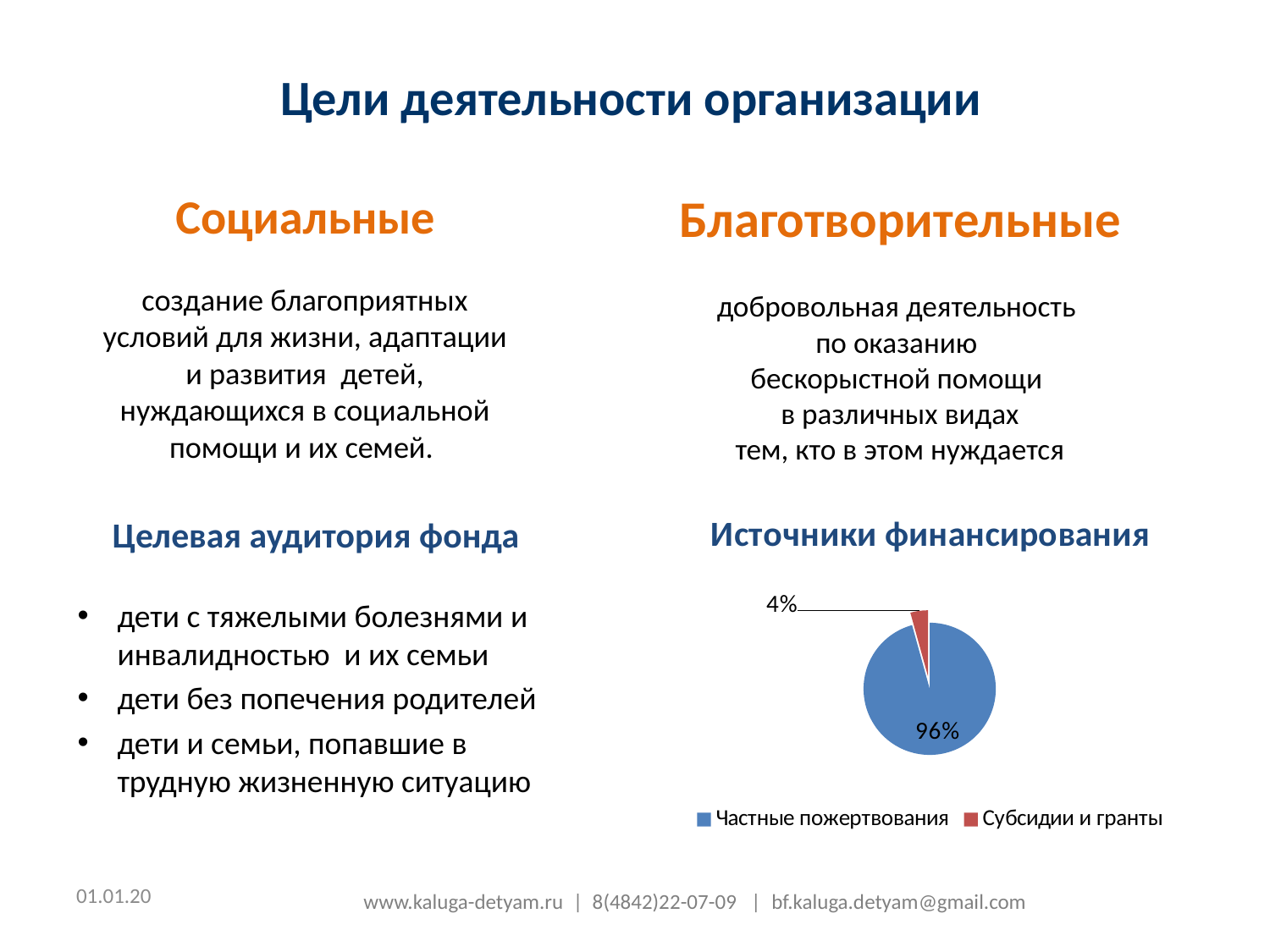
How many slices does the pie chart have? 2 What colour is the "Субсидии и гранты" slice in the pie chart? red Which funding source has the largest slice in the pie chart? Частные пожертвования What share of the pie chart does "Частные пожертвования" represent? 96% What is the title shown above the pie chart? Источники финансирования Which funding source has the smallest slice in the pie chart? Субсидии и гранты How many entries does the legend of the pie chart list? 2 What is the difference in percentage points between "Частные пожертвования" and "Субсидии и гранты" in the pie chart? 92 What kind of chart is shown under "Источники финансирования"? pie chart What share of the pie chart does "Субсидии и гранты" represent? 4% Which is larger in the pie chart: "Частные пожертвования" or "Субсидии и гранты"? Частные пожертвования